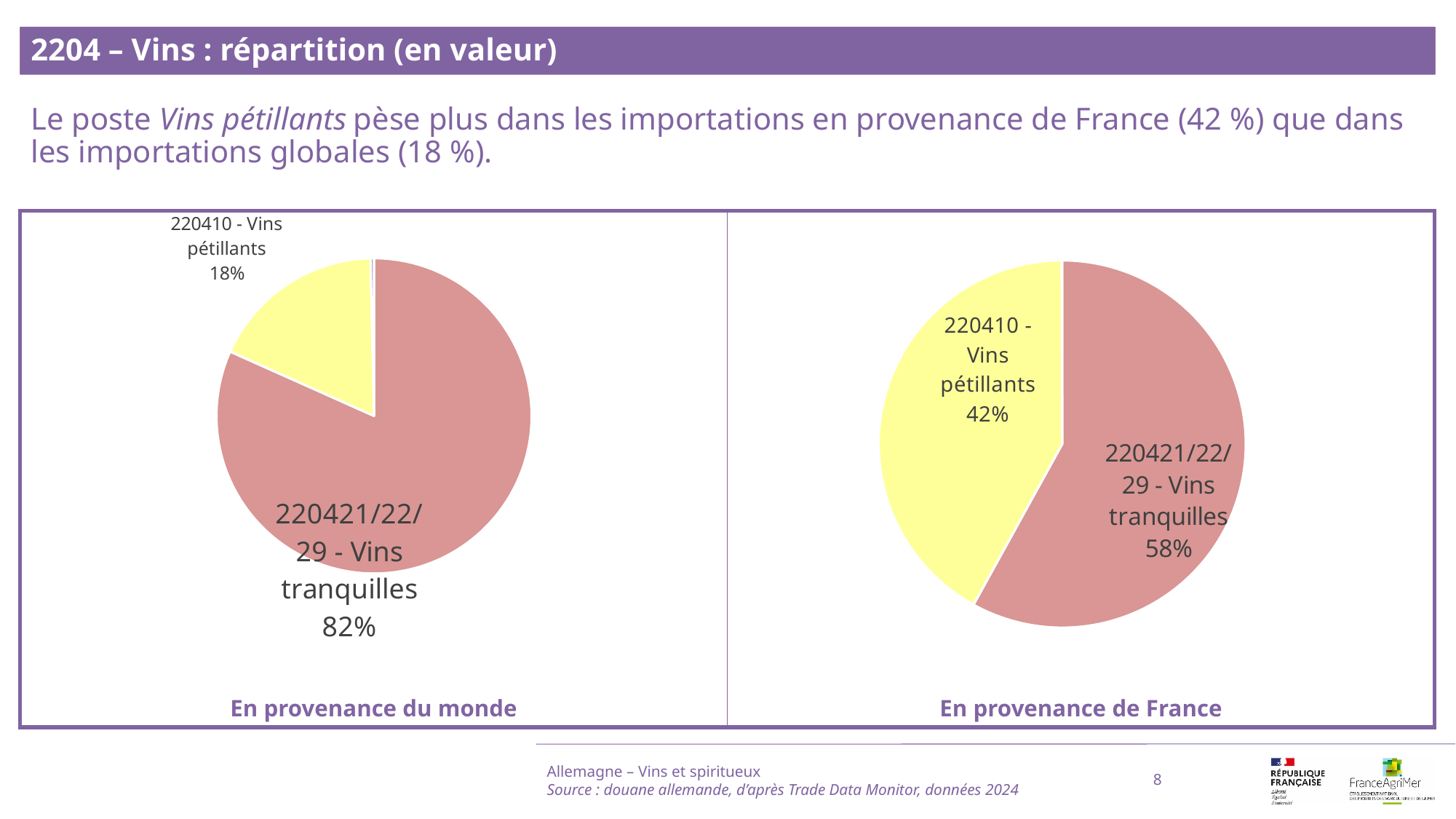
In the 'En provenance de France' chart, what share is shown for 220410 - Vins pétillants? 42% In the 'En provenance du monde' chart, what share is shown for 220421/22/29 - Vins tranquilles? 82% What colour is the Vins pétillants slice in both pie charts? Yellow What is the difference in percentage points between the Vins pétillants share in the 'En provenance de France' chart and in the 'En provenance du monde' chart? 24 percentage points In the 'En provenance du monde' chart, what share is shown for 220410 - Vins pétillants? 18% How many labelled slices does the 'En provenance de France' chart have? 2 Is the share of Vins pétillants larger in the 'En provenance du monde' chart or in the 'En provenance de France' chart? En provenance de France In the 'En provenance de France' chart, which category has the largest slice? 220421/22/29 - Vins tranquilles What kind of chart is the 'En provenance du monde' chart? Pie chart In the 'En provenance de France' chart, what is the difference in percentage points between Vins tranquilles and Vins pétillants? 16 percentage points